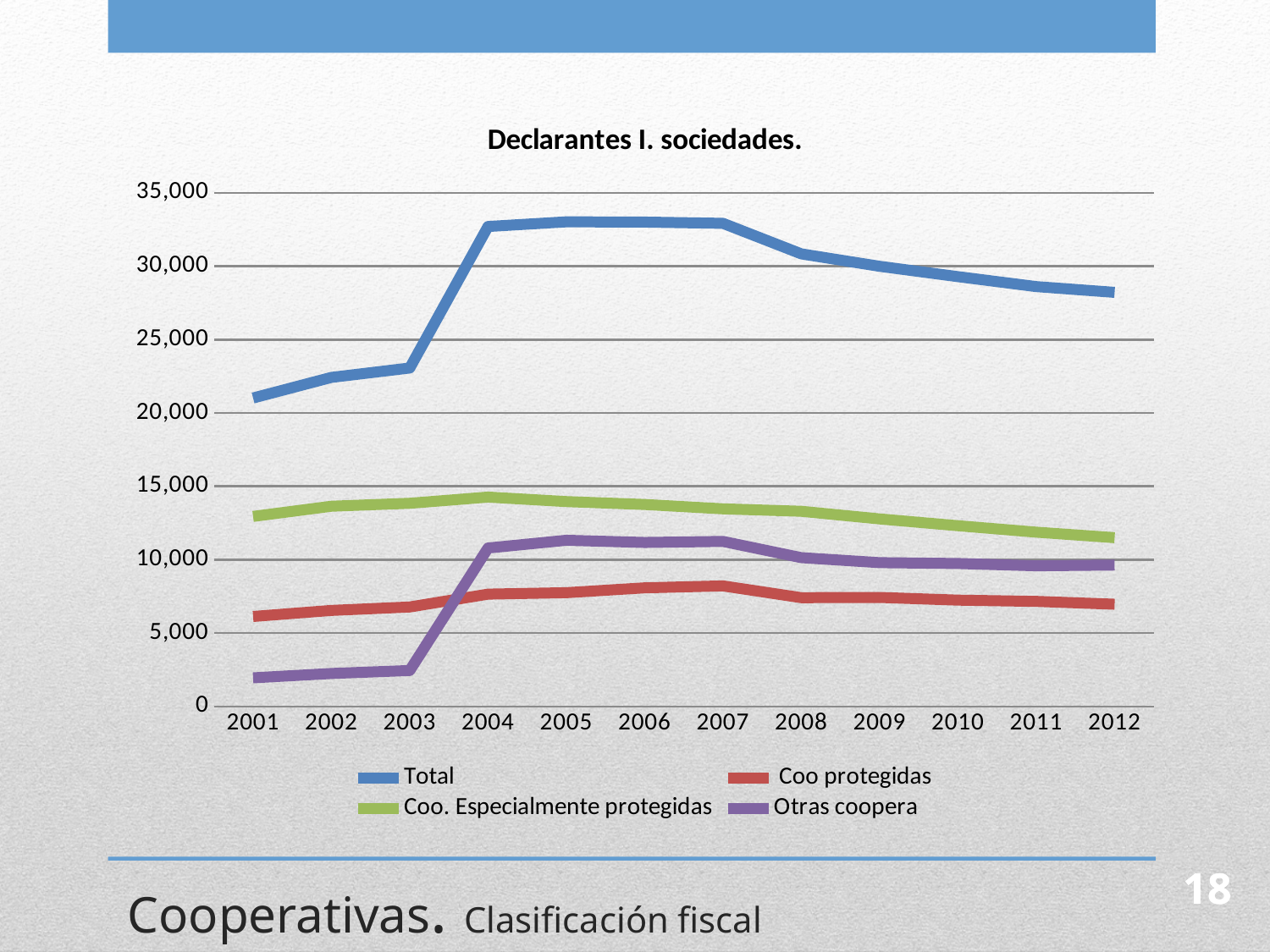
How many years are plotted along the x axis? 12 Is the value for Otras coopera in 2001 greater or less than 5,000? less In which year does the Coo. Especialmente protegidas series reach its highest value? 2004 Is the value for Coo protegidas in 2007 greater or less than 5,000? greater Does the Total series rise or fall from 2007 to 2012? Fall Is the value for Total in 2004 greater or less than 30,000? greater In which year is the Total series at its lowest? 2001 Which series is drawn in green in the legend? Coo. Especialmente protegidas What is the title of the chart? Declarantes I. sociedades. What kind of chart is shown on the slide? Line chart How many series does the legend list? 4